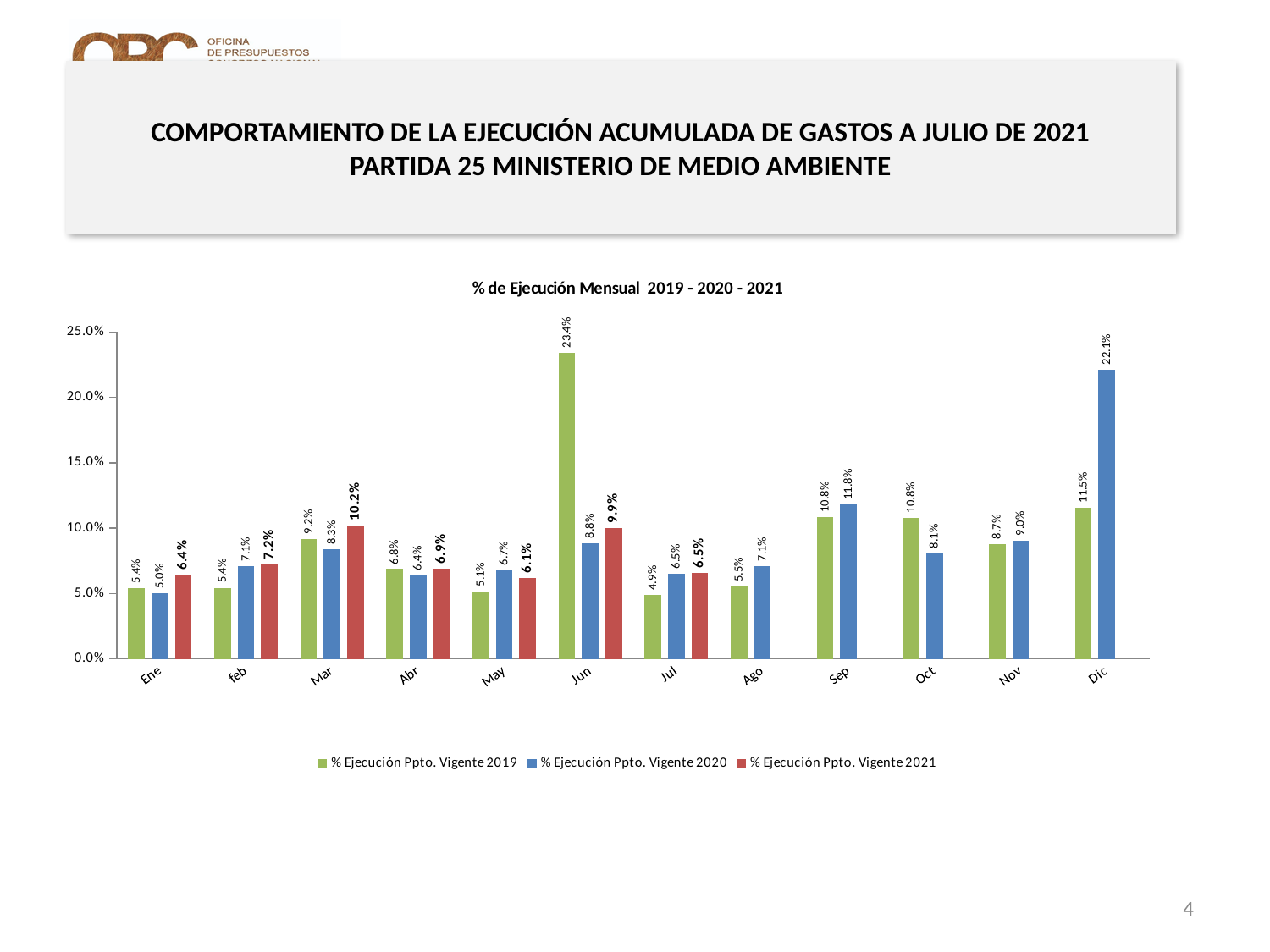
What is the title of the chart? % de Ejecución Mensual 2019 - 2020 - 2021 What is the value for % Ejecución Ppto. Vigente 2020 in Dic? 22.1% What kind of chart is shown on the slide? Bar chart How many months are shown on the x axis? 12 Which month has the highest value for % Ejecución Ppto. Vigente 2019? Jun Which month has the lowest value for % Ejecución Ppto. Vigente 2020? Ene What is the difference between the 2019 and 2020 values in Jun? 14.6% Is the value for % Ejecución Ppto. Vigente 2020 in Dic greater or less than 20.0%? greater Which is larger in Sep: the 2019 value or the 2020 value? 2020 How many series does the legend list? 3 What is the value for % Ejecución Ppto. Vigente 2021 in Mar? 10.2% What is the value for % Ejecución Ppto. Vigente 2019 in Jun? 23.4%